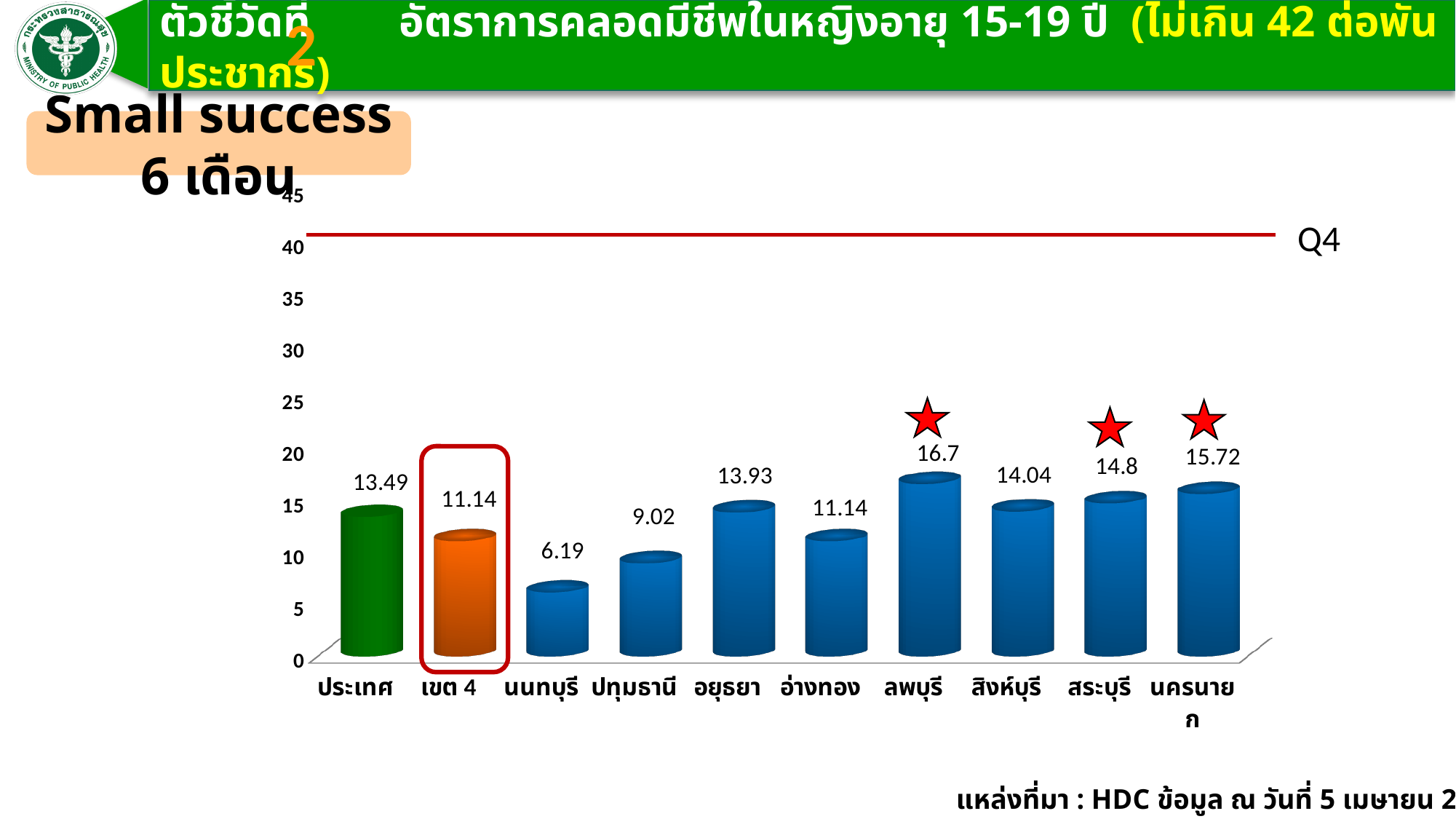
Is the value for นครนายก greater or less than 20? less What is the value for เขต 4? 11.14 What is the difference between the values for ลพบุรี and นนทบุรี? 10.51 How many categories are shown on the x axis? 10 Which category has the highest value? ลพบุรี What is the value for ประเทศ? 13.49 What label is shown next to the red horizontal line at the top of the chart? Q4 What is the value for นนทบุรี? 6.19 Which is larger, the value for สระบุรี or the value for สิงห์บุรี? สระบุรี What kind of chart is shown on the slide? bar chart What is the value for ลพบุรี? 16.7 Which category has the lowest value? นนทบุรี